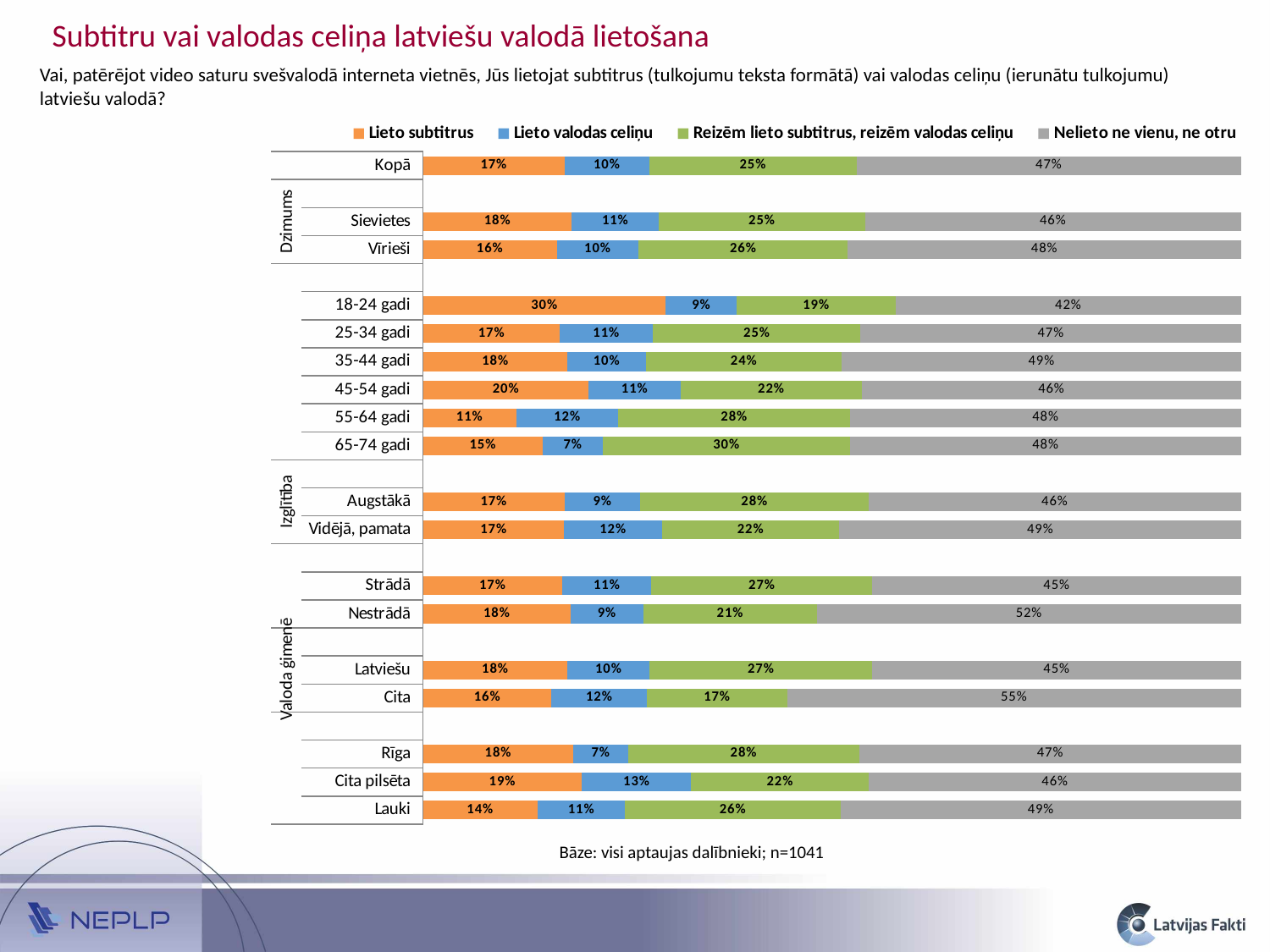
What is the value of 'Nelieto ne vienu, ne otru' for Kopā? 47% Which is larger: the 'Nelieto ne vienu, ne otru' value for Nestrādā or for Strādā? Nestrādā Which category has the highest value for 'Nelieto ne vienu, ne otru'? Cita Which category has the lowest value for 'Lieto subtitrus'? 55-64 gadi What is the value of 'Reizēm lieto subtitrus, reizēm valodas celiņu' for 65-74 gadi? 30% What is the value of 'Lieto subtitrus' for 18-24 gadi? 30% What is the sample size stated below the chart? n=1041 Which category has the lowest value for 'Reizēm lieto subtitrus, reizēm valodas celiņu'? Cita What is the value of 'Lieto valodas celiņu' for Cita pilsēta? 13% What is the difference between the 'Lieto subtitrus' values for 18-24 gadi and 55-64 gadi? 19% How many series does the legend list? 4 What kind of chart is shown on the slide? Stacked bar chart